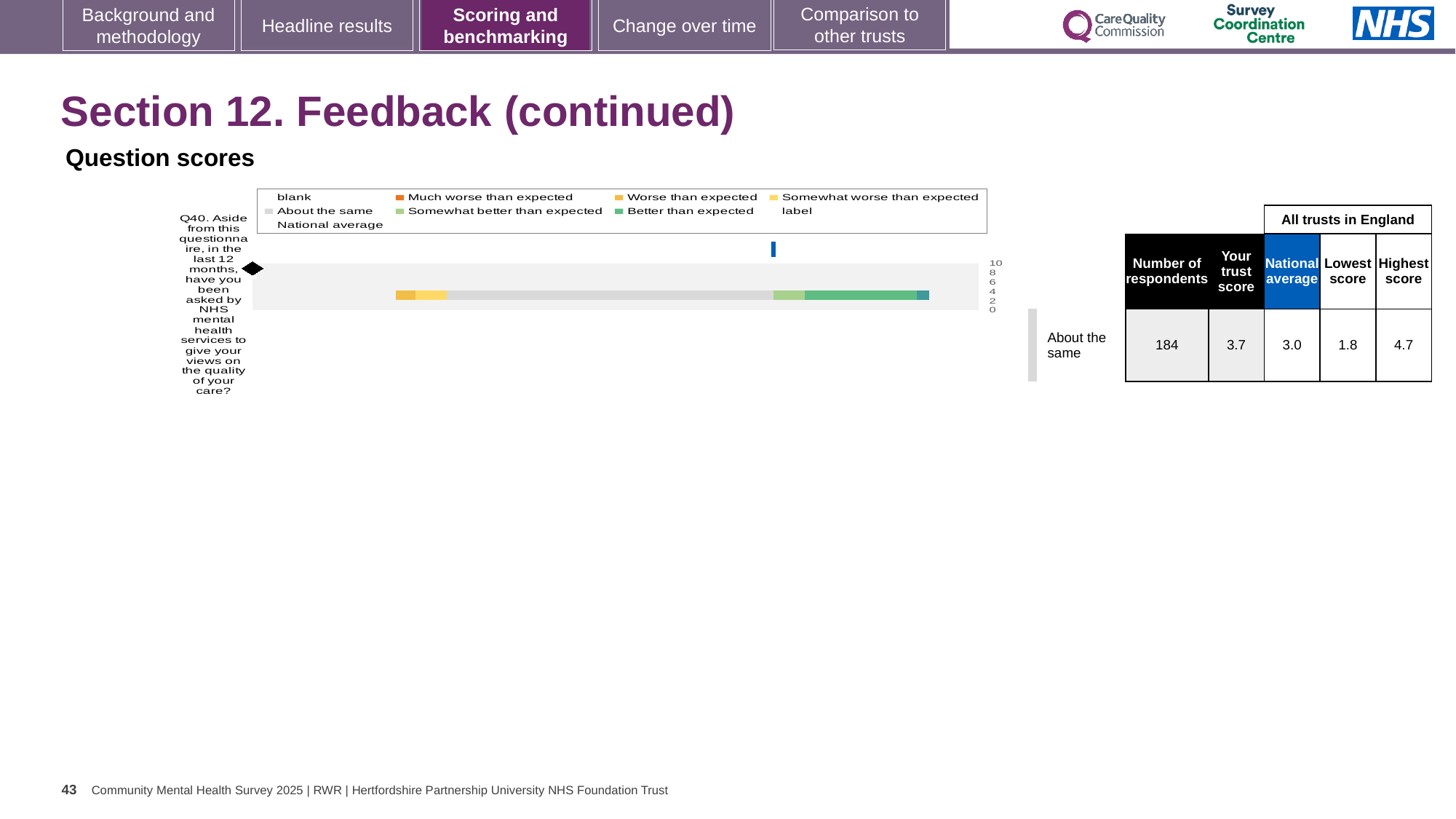
How many entries does the chart legend list? 9 How many question categories are plotted on the chart? 1 Is the trust's score for Q40 larger or smaller than the national average? larger What is the highest tick value shown on the chart's axis? 10 In the table beside the chart, what is the national average for Q40? 3.0 What kind of chart is shown on the slide? bar chart Which question is plotted on the chart? Q40. Aside from this questionnaire, in the last 12 months, have you been asked by NHS mental health services to give your views on the quality of your care? In the table beside the chart, what is the lowest score among all trusts in England for Q40? 1.8 What is the difference between the highest and lowest scores among all trusts in England for Q40? 2.9 In the table beside the chart, what is the highest score among all trusts in England for Q40? 4.7 In the table beside the chart, what is the trust's score for Q40? 3.7 In the table beside the chart, what is the number of respondents for Q40? 184